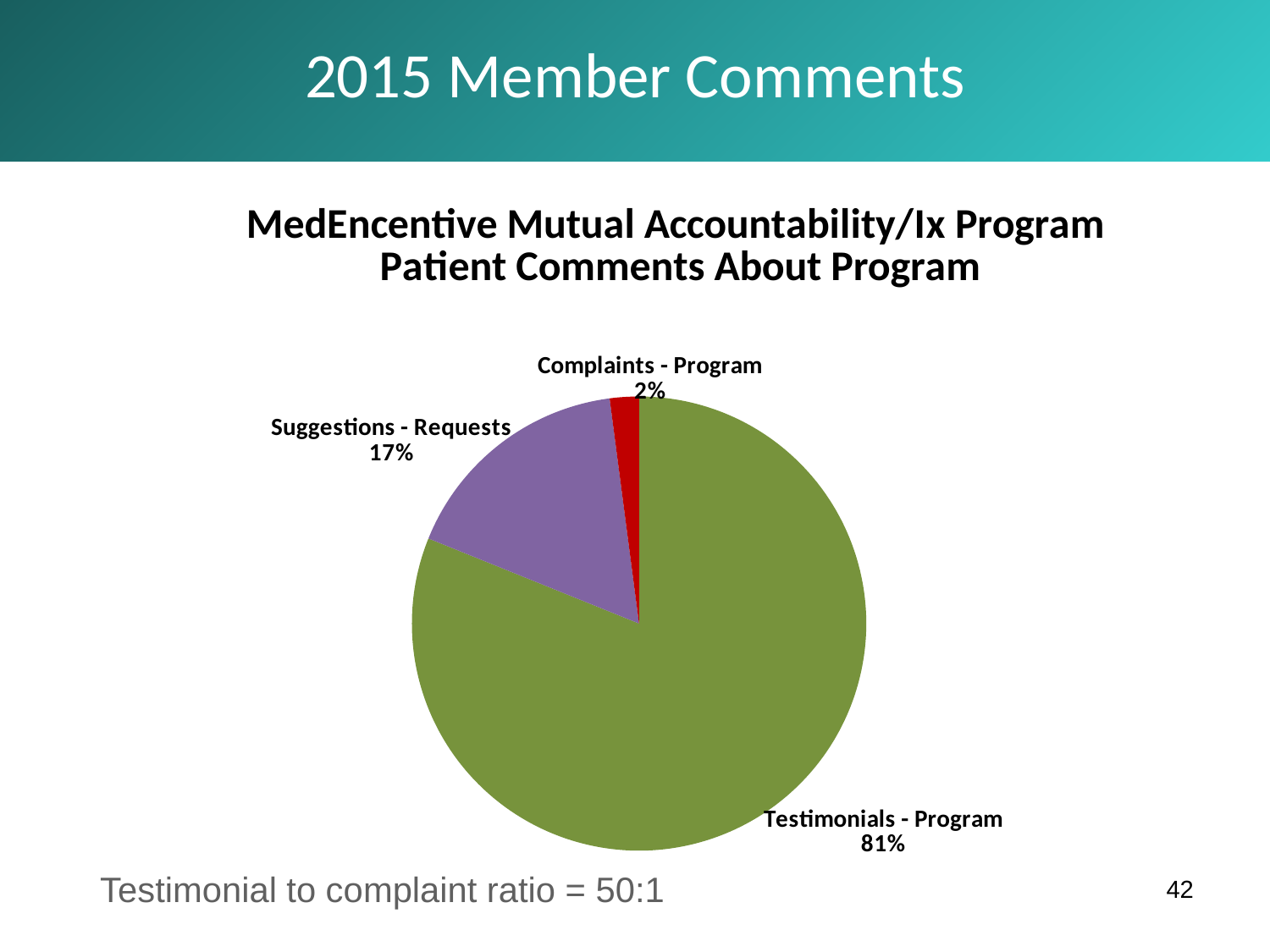
What colour is the Testimonials - Program slice? green What share of patient comments are Complaints - Program? 2% What share of patient comments are Testimonials - Program? 81% What is the difference in percentage points between Testimonials - Program and Suggestions - Requests? 64 What kind of chart is shown on the slide? pie chart What share of patient comments are Suggestions - Requests? 17% What is the difference in percentage points between Suggestions - Requests and Complaints - Program? 15 Which category has the largest slice of the pie? Testimonials - Program Which is larger, Suggestions - Requests or Complaints - Program? Suggestions - Requests Which category has the smallest slice of the pie? Complaints - Program How many categories are shown in the pie chart? 3 What is the title of the chart? MedEncentive Mutual Accountability/Ix Program Patient Comments About Program